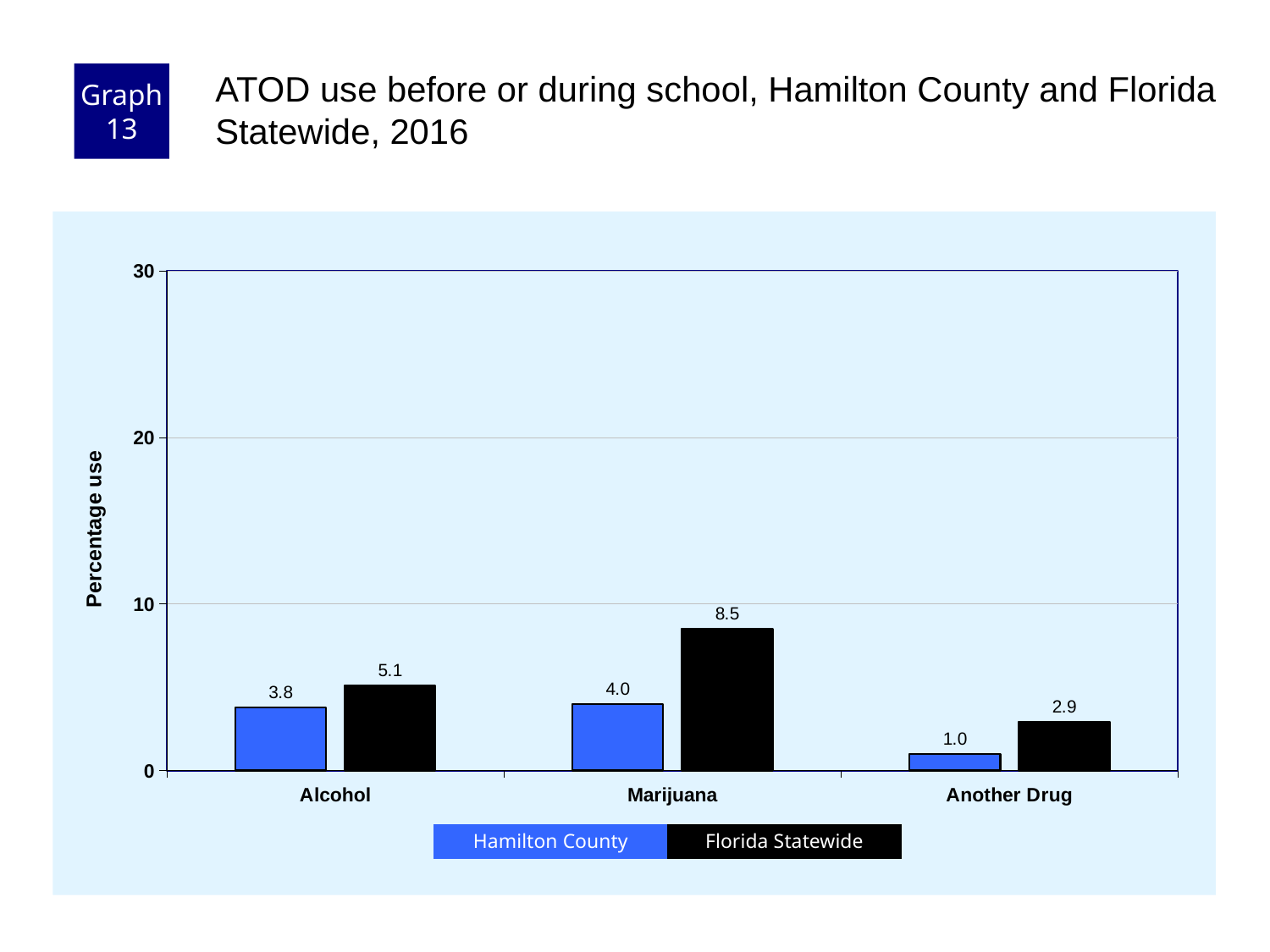
Which category has the lowest Hamilton County value? Another Drug Which category has the highest Florida Statewide value? Marijuana What is the Hamilton County value for Alcohol? 3.8 Which is larger for Alcohol, the Hamilton County value or the Florida Statewide value? Florida Statewide How many series does the legend list? 2 What is the Hamilton County value for Another Drug? 1.0 Is the Florida Statewide value for Marijuana greater or less than 10? less What is the Florida Statewide value for Another Drug? 2.9 What is the Florida Statewide value for Marijuana? 8.5 What is the difference between the Florida Statewide and Hamilton County values for Marijuana? 4.5 How many categories are shown on the x axis? 3 What kind of chart is shown on the slide? bar chart